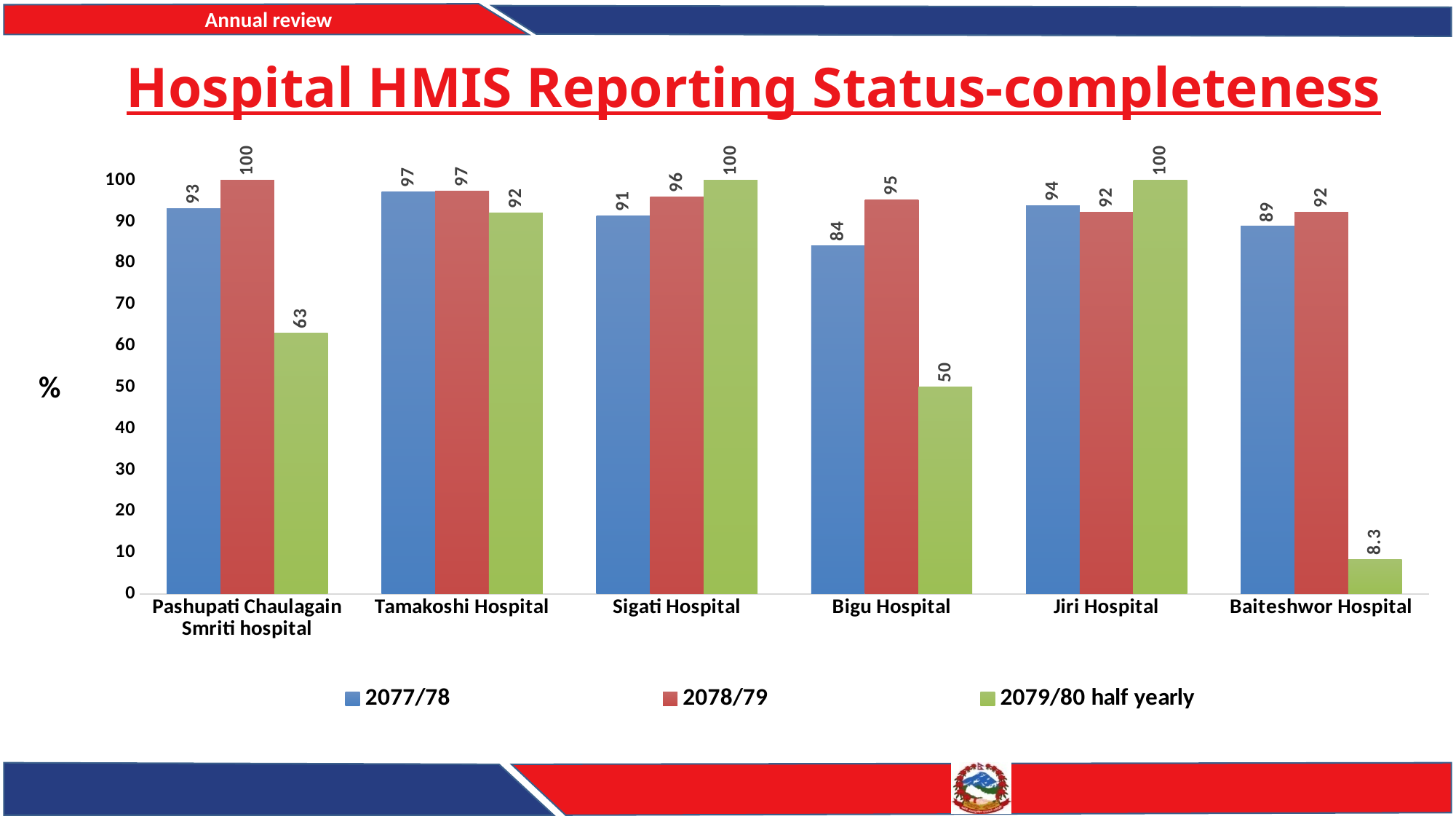
What kind of chart is shown on the slide? Bar chart What is the 2079/80 half yearly value for Baiteshwor Hospital? 8.3 Which is larger for Jiri Hospital: the 2077/78 value or the 2078/79 value? 2077/78 What is the title of the chart? Hospital HMIS Reporting Status-completeness How many hospitals are shown on the x axis? 6 Which hospital has the lowest 2079/80 half yearly value? Baiteshwor Hospital Which colour represents the 2079/80 half yearly series? Green Which hospital has the highest 2077/78 value? Tamakoshi Hospital What is the 2078/79 value for Pashupati Chaulagain Smriti hospital? 100 How many series does the legend list? 3 What is the 2077/78 value for Bigu Hospital? 84 What is the difference between the 2078/79 and 2079/80 half yearly values for Bigu Hospital? 45